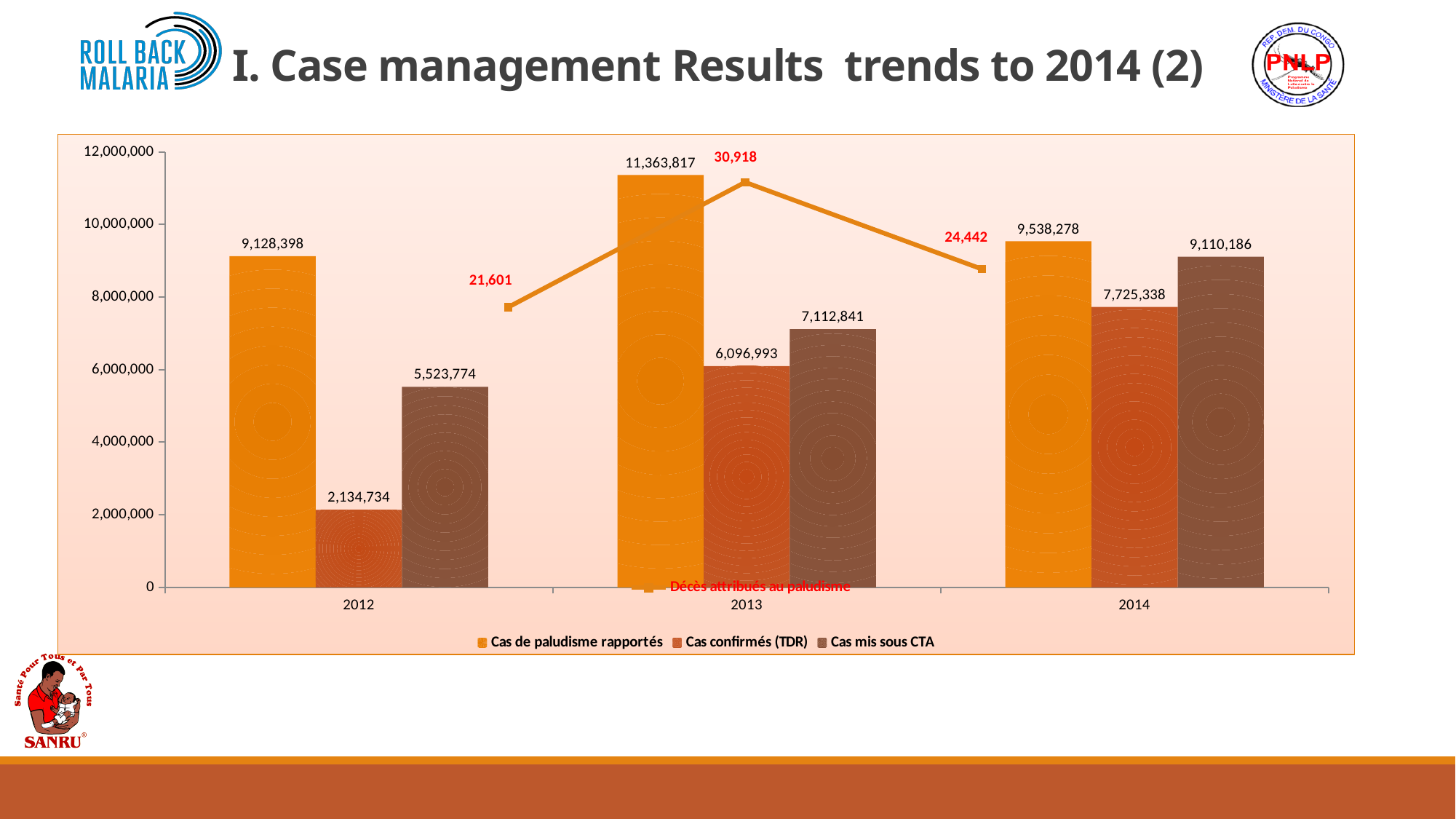
Which is larger: Cas mis sous CTA in 2012 or Cas confirmés (TDR) in 2013? Cas confirmés (TDR) in 2013 What is the difference between Cas de paludisme rapportés and Cas mis sous CTA in 2014? 428,092 How many years are shown on the x axis? 3 What is the value for Cas confirmés (TDR) in 2012? 2,134,734 Do the values for Cas confirmés (TDR) rise or fall from 2012 to 2014? rise What is the value for Cas mis sous CTA in 2014? 9,110,186 By how much did Décès attribués au paludisme increase from 2012 to 2013? 9,317 In which year is Cas confirmés (TDR) lowest? 2012 What is the value of Décès attribués au paludisme shown for 2013? 30,918 How many series does the legend list? 3 What is the value for Cas de paludisme rapportés in 2013? 11,363,817 In which year is Cas de paludisme rapportés highest? 2013